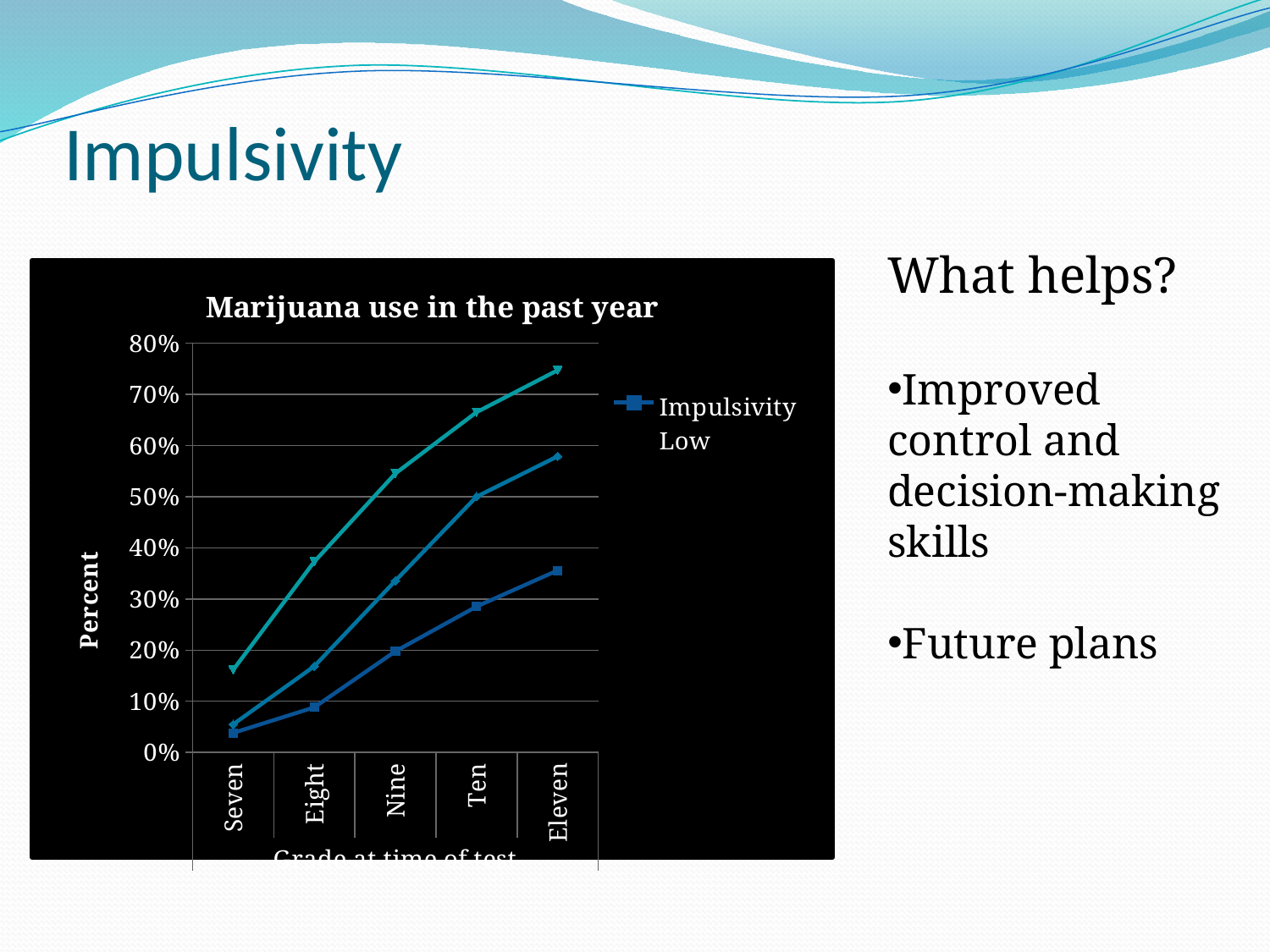
At which grade is the Impulsivity Low value lowest? Seven What is the label on the vertical axis of the chart? Percent What is the title of the chart? Marijuana use in the past year Does the Impulsivity Low line rise or fall from grade Seven to grade Eleven? rise Is the value for Impulsivity Low at grade Eleven greater or less than 30%? greater For Impulsivity Low, which grade has the larger value, Seven or Eleven? Eleven Is the value for Impulsivity Low at grade Eleven greater or less than 40%? less How many grade categories are shown on the x axis of the chart? 5 What kind of chart is shown on the slide? line chart At which grade is the Impulsivity Low value highest? Eleven Is the value for Impulsivity Low at grade Seven greater or less than 10%? less How many series does the chart's legend list? 1